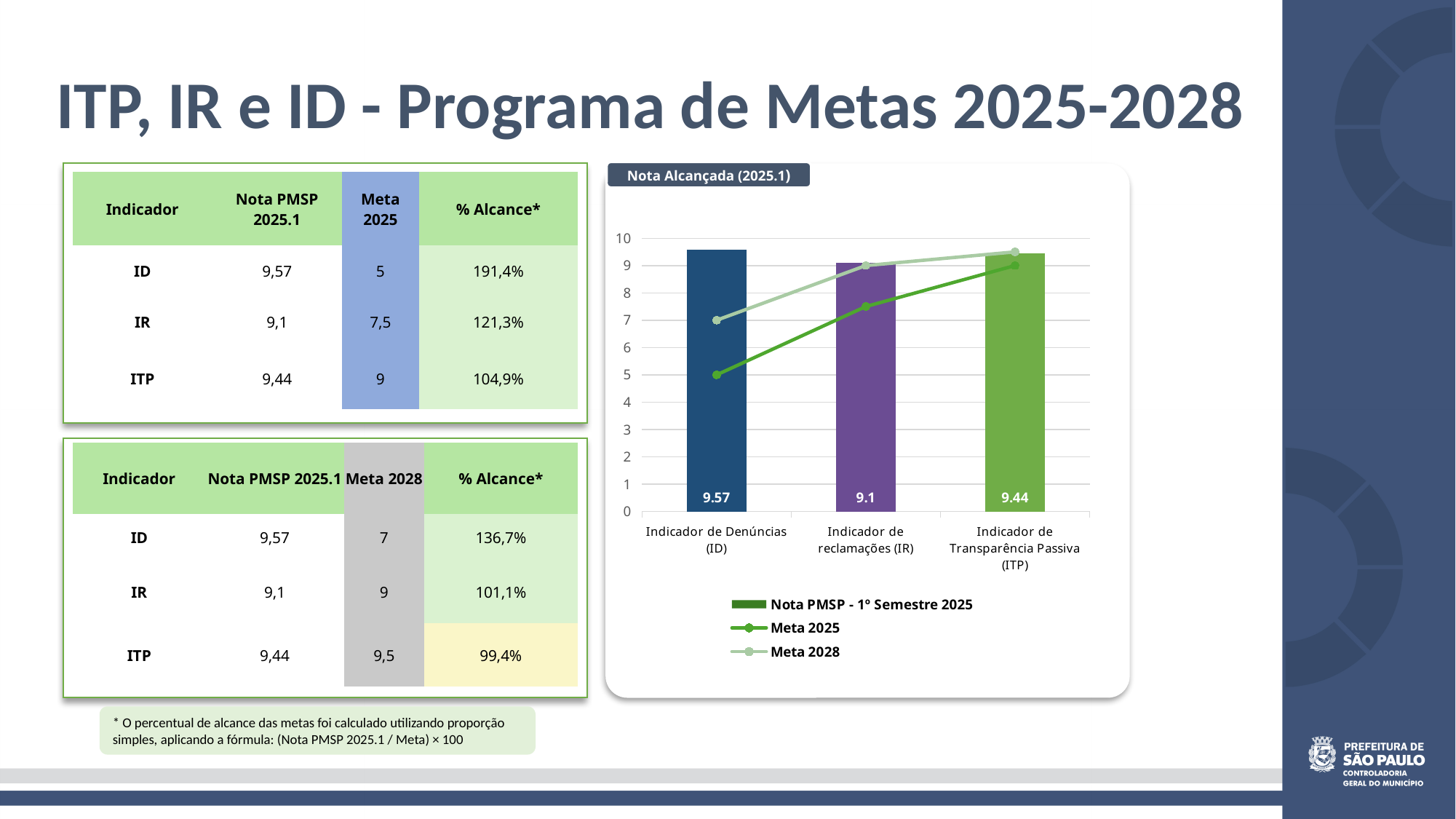
Is the Meta 2025 value for Indicador de reclamações (IR) greater or less than 8? less How many indicators are shown on the x axis of the chart? 3 What type of chart is shown on the slide? bar chart with lines Which indicator has the highest Nota PMSP bar in the chart? Indicador de Denúncias (ID) Which indicator has the lowest Nota PMSP bar in the chart? Indicador de reclamações (IR) What is the title of the chart? Nota Alcançada (2025.1) Is the Nota PMSP bar for ID larger or smaller than the bar for ITP? larger How many series does the chart legend list? 3 What is the Nota PMSP value for Indicador de Transparência Passiva (ITP) in the chart? 9.44 What is the Nota PMSP value for Indicador de reclamações (IR) in the chart? 9.1 What is the Nota PMSP value for Indicador de Denúncias (ID) in the chart? 9.57 What is the difference between the Nota PMSP bars for ID and IR? 0.47